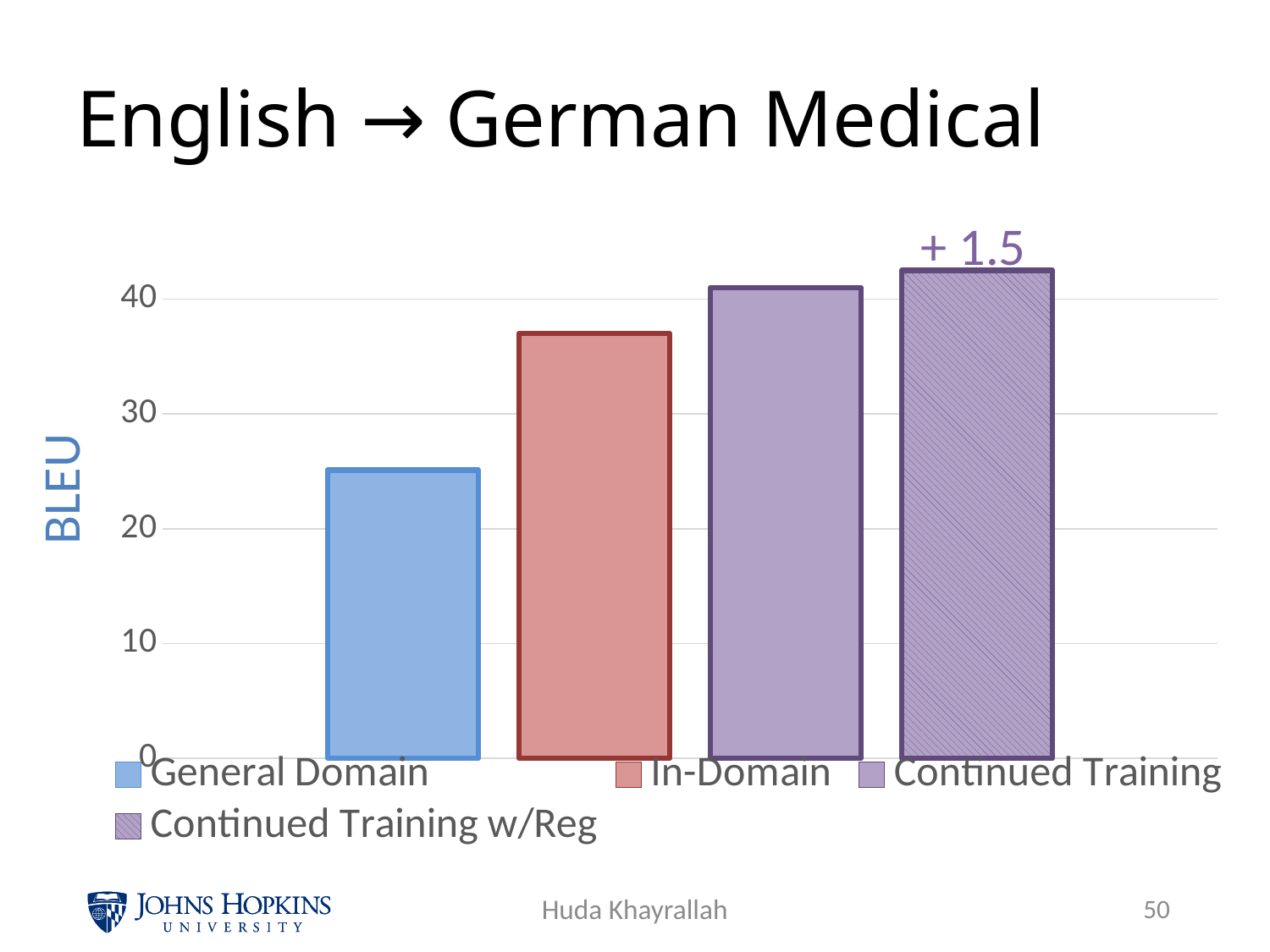
Do the BLEU scores rise or fall from left to right across the bars? rise What kind of chart is shown on the slide? bar chart Is the BLEU score for General Domain greater or less than 30? less How many series does the legend list? 4 What improvement is annotated above the Continued Training w/Reg bar? + 1.5 Which series has the lowest BLEU score? General Domain Is the BLEU score for In-Domain greater or less than 40? less Is the BLEU score for Continued Training greater or less than 40? greater Which has a higher BLEU score, General Domain or In-Domain? In-Domain Which series has the highest BLEU score? Continued Training w/Reg What is the label on the vertical axis? BLEU